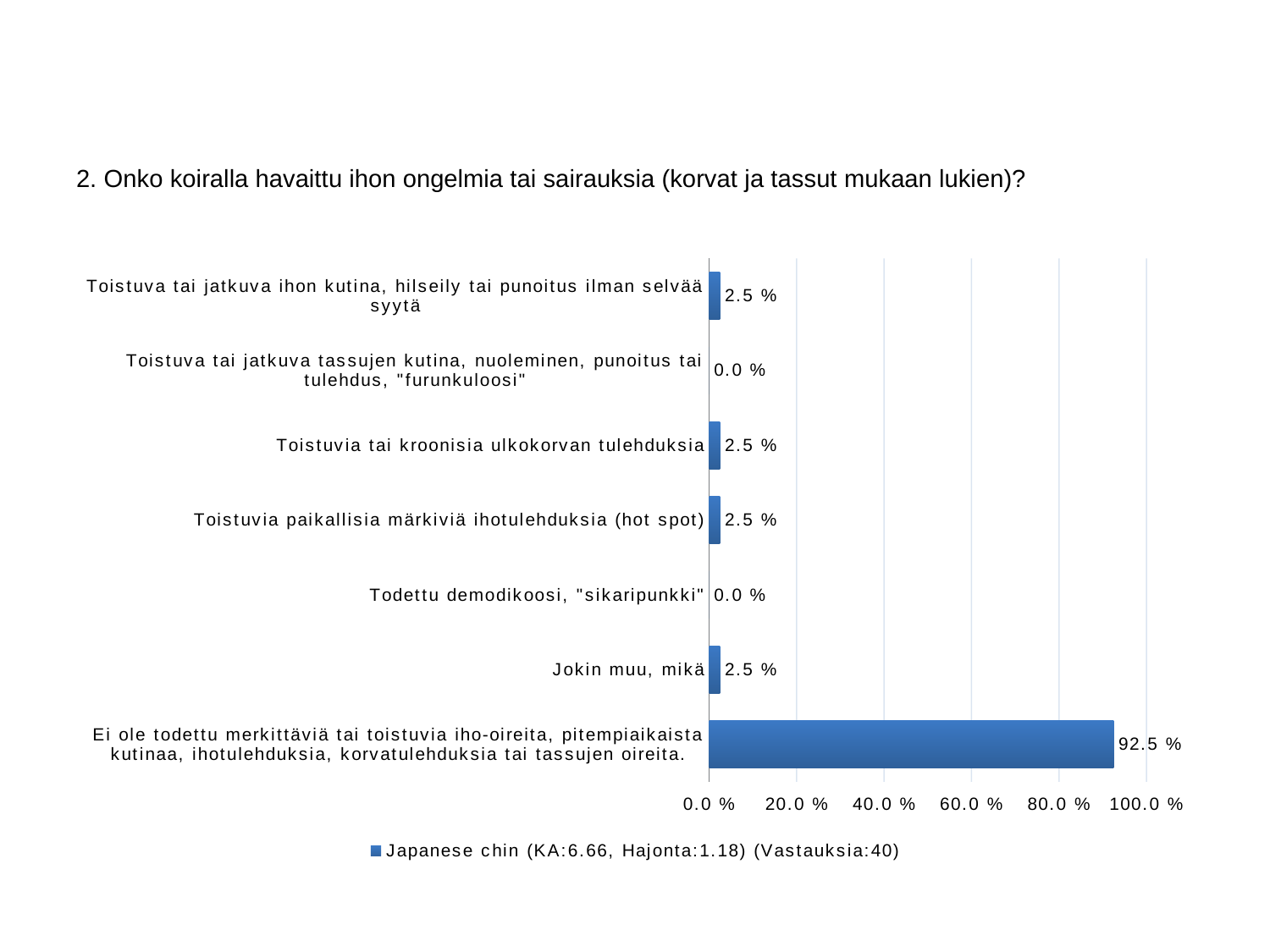
What is the difference between the value for "Ei ole todettu merkittäviä tai toistuvia iho-oireita..." and the value for "Jokin muu, mikä"? 90.0 % Is the value for "Ei ole todettu merkittäviä tai toistuvia iho-oireita..." greater or less than 80.0 %? greater How many categories are shown in the chart? 7 What kind of chart is shown on the slide? bar chart How many series does the legend list? 1 What is the value for "Toistuvia tai kroonisia ulkokorvan tulehduksia"? 2.5 % Which category has the highest value? Ei ole todettu merkittäviä tai toistuvia iho-oireita, pitempiaikaista kutinaa, ihotulehduksia, korvatulehduksia tai tassujen oireita. Which is larger: the value for "Toistuvia paikallisia märkiviä ihotulehduksia (hot spot)" or the value for "Todettu demodikoosi, "sikaripunkki""? Toistuvia paikallisia märkiviä ihotulehduksia (hot spot) What is the legend entry for the series shown? Japanese chin (KA:6.66, Hajonta:1.18) (Vastauksia:40) What is the value for "Todettu demodikoosi, "sikaripunkki""? 0.0 % What is the value for the category with the highest value? 92.5 % What is the value for "Jokin muu, mikä"? 2.5 %